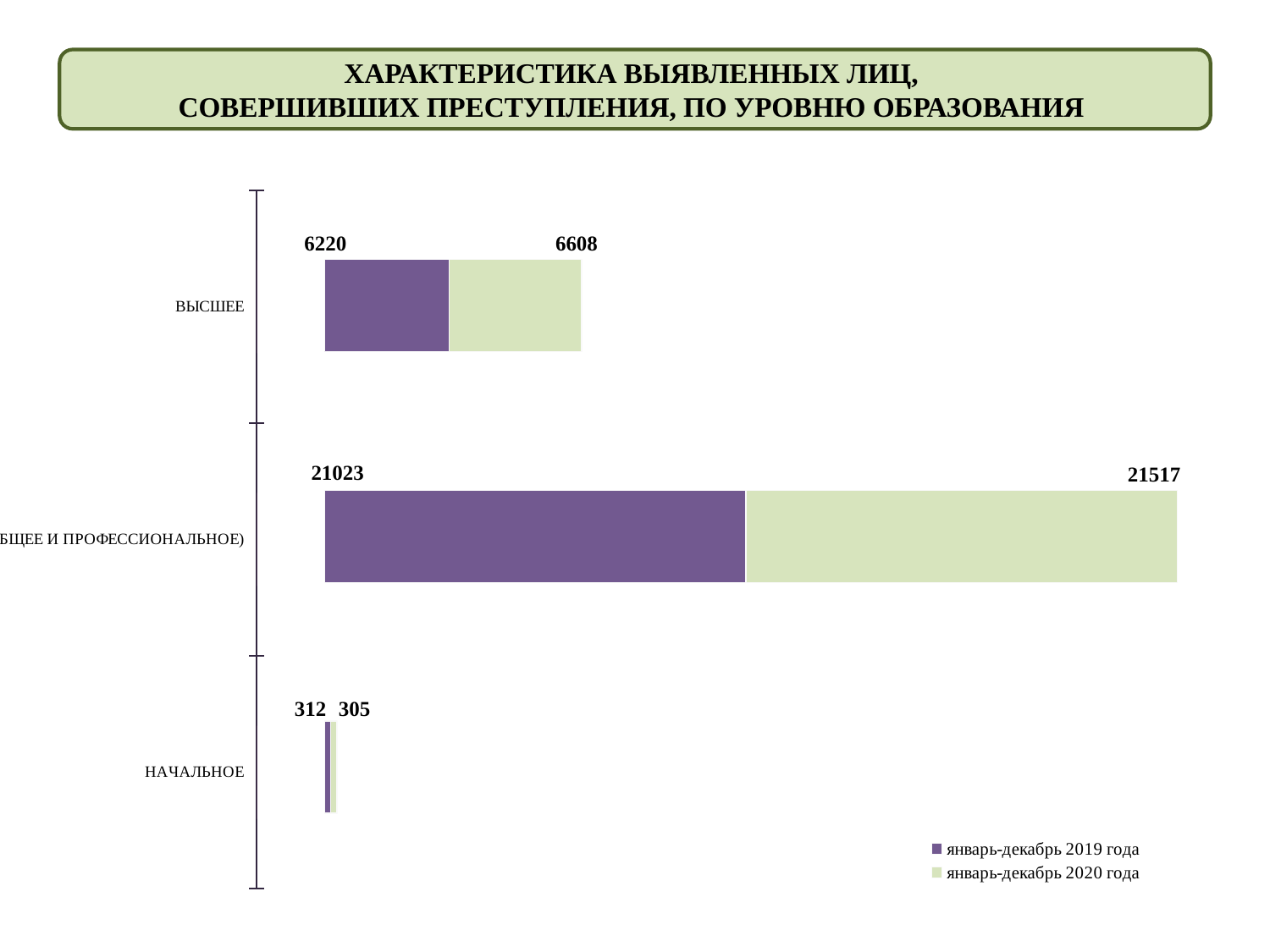
What is the январь-декабрь 2020 года value for the middle category of the chart? 21517 What is the value for НАЧАЛЬНОЕ in the январь-декабрь 2019 года series? 312 How many series does the legend list? 2 What is the value for ВЫСШЕЕ in the январь-декабрь 2019 года series? 6220 Which is larger for НАЧАЛЬНОЕ: the январь-декабрь 2019 года value or the январь-декабрь 2020 года value? январь-декабрь 2019 года What is the difference between the январь-декабрь 2020 года and январь-декабрь 2019 года values for ВЫСШЕЕ? 388 What is the value for ВЫСШЕЕ in the январь-декабрь 2020 года series? 6608 What is the total of the stacked bar for ВЫСШЕЕ? 12828 Which category has the lowest value in the январь-декабрь 2019 года series? НАЧАЛЬНОЕ What kind of chart is shown on the slide? Stacked bar chart What is the value for НАЧАЛЬНОЕ in the январь-декабрь 2020 года series? 305 How many categories are shown on the chart? 3